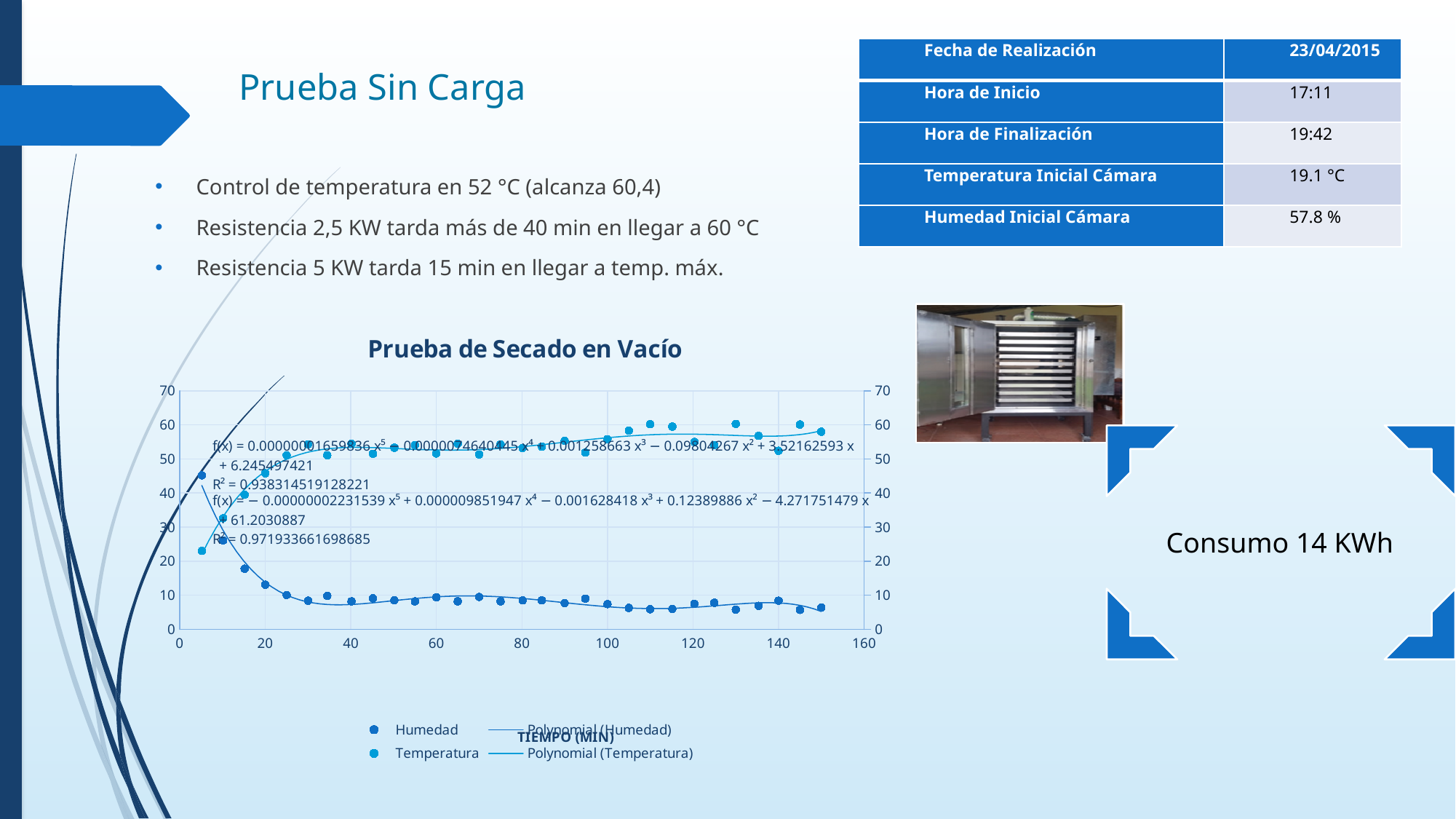
Does the Temperatura series rise or fall overall as time increases from 0 to 40 minutes? rise At 150 minutes, which series has the larger value, Humedad or Temperatura? Temperatura Is the Temperatura value at 5 minutes greater or less than 30? less How many entries does the chart legend list? 4 What kind of chart is 'Prueba de Secado en Vacío'? scatter chart What is the label of the x axis of the chart? TIEMPO (MIN) What is the title of the chart on the slide? Prueba de Secado en Vacío Is the Humedad value at 5 minutes greater or less than 40? greater Is the Temperatura value at 100 minutes greater or less than 50? greater What is the higher of the two R² values printed on the chart? 0.971933661698685 Does the Humedad series rise or fall overall as time increases from 0 to 40 minutes? fall